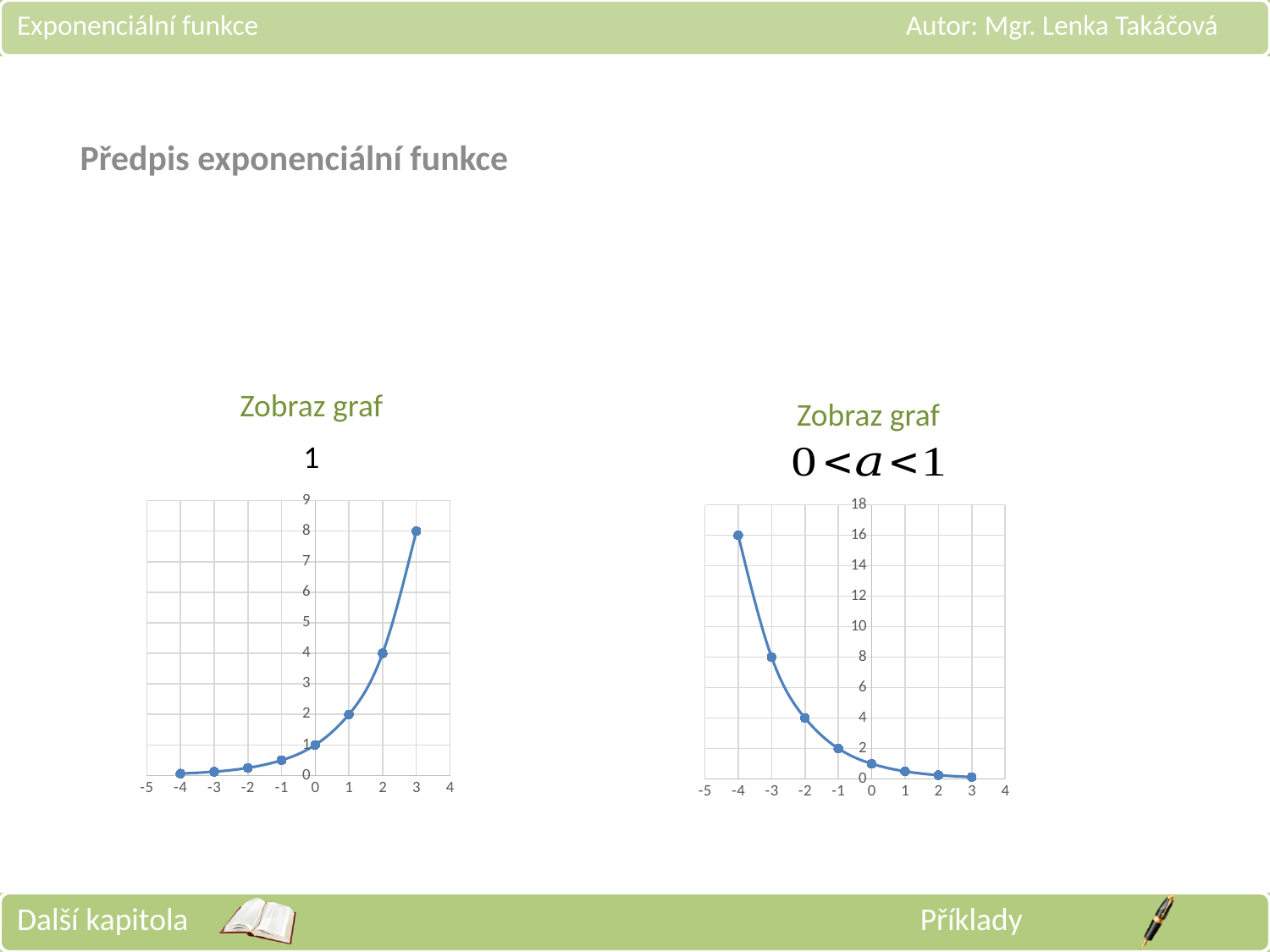
On the right chart titled 0 < a < 1, what is the y value of the point at x = -3? 8 On the left chart, what is the y value of the point at x = 2? 4 On the right chart titled 0 < a < 1, what is the difference between the y values at x = -4 and x = -3? 8 On the left chart, do the values rise or fall as x increases? rise On the right chart titled 0 < a < 1, what is the y value of the point at x = -4? 16 On the left chart, what is the y value of the point at x = 1? 2 How many data points are plotted on the right chart titled 0 < a < 1? 8 On the right chart titled 0 < a < 1, do the values rise or fall as x increases? fall What kind of chart is the left chart on the slide? line chart On the left chart, what is the y value of the point at x = 3? 8 On the right chart titled 0 < a < 1, what is the y value of the point at x = -2? 4 On the left chart, is the value at x = -1 greater or less than 1? less